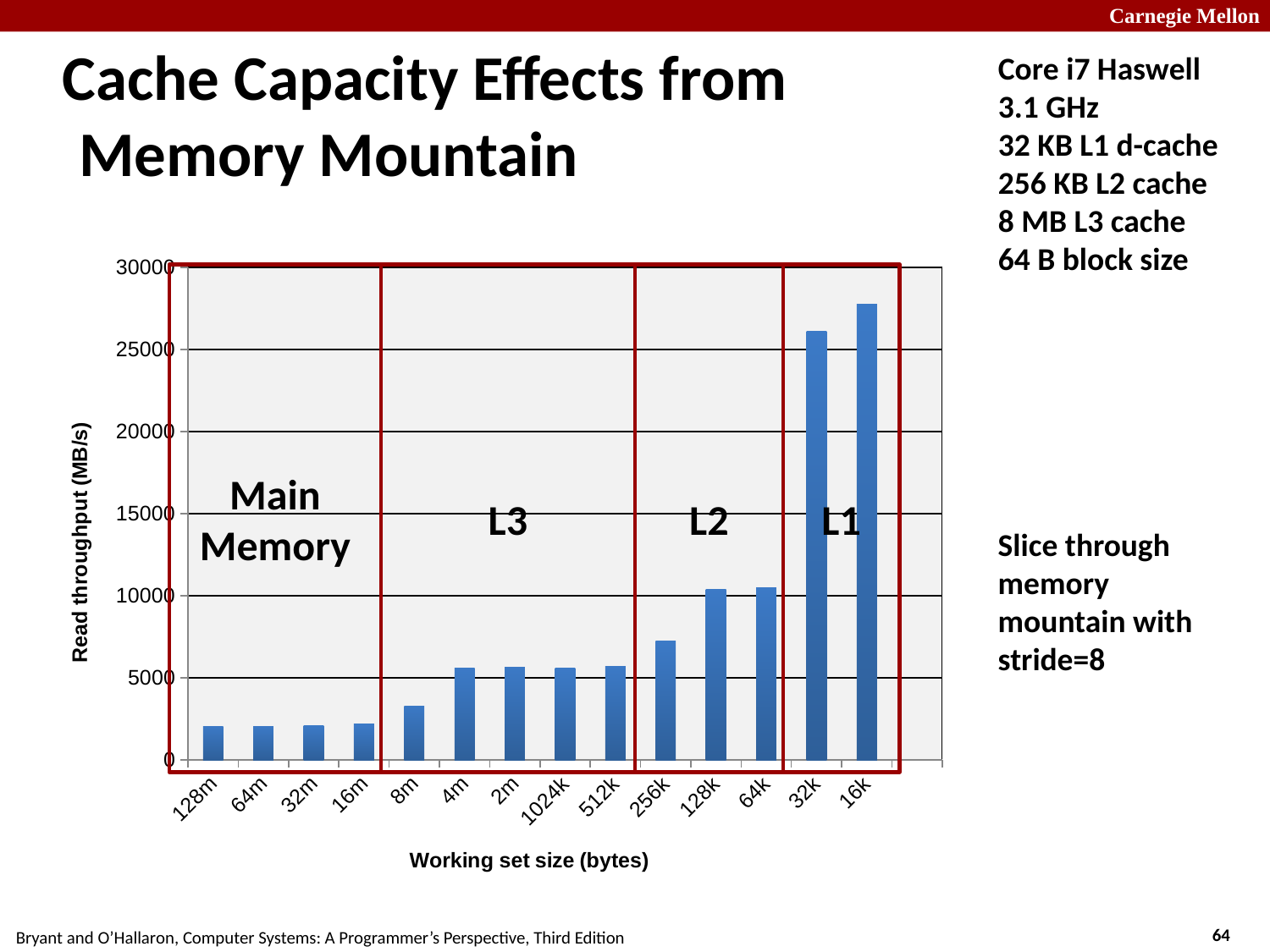
What kind of chart is shown on the slide? bar chart What is the label of the y axis? Read throughput (MB/s) Is the read throughput for a working set size of 16k greater or less than 25000? greater Is the read throughput for a working set size of 256k greater or less than 10000? less Is the read throughput for a working set size of 128m greater or less than 5000? less Which has the higher read throughput, a working set size of 256k or 512k? 256k Which has the higher read throughput, a working set size of 32k or 64k? 32k Which working set size has the highest read throughput? 16k Which cache level label is placed over the two rightmost bars? L1 Do the read throughput values generally rise or fall moving from left to right along the x axis? rise How many working set sizes are plotted along the x axis? 14